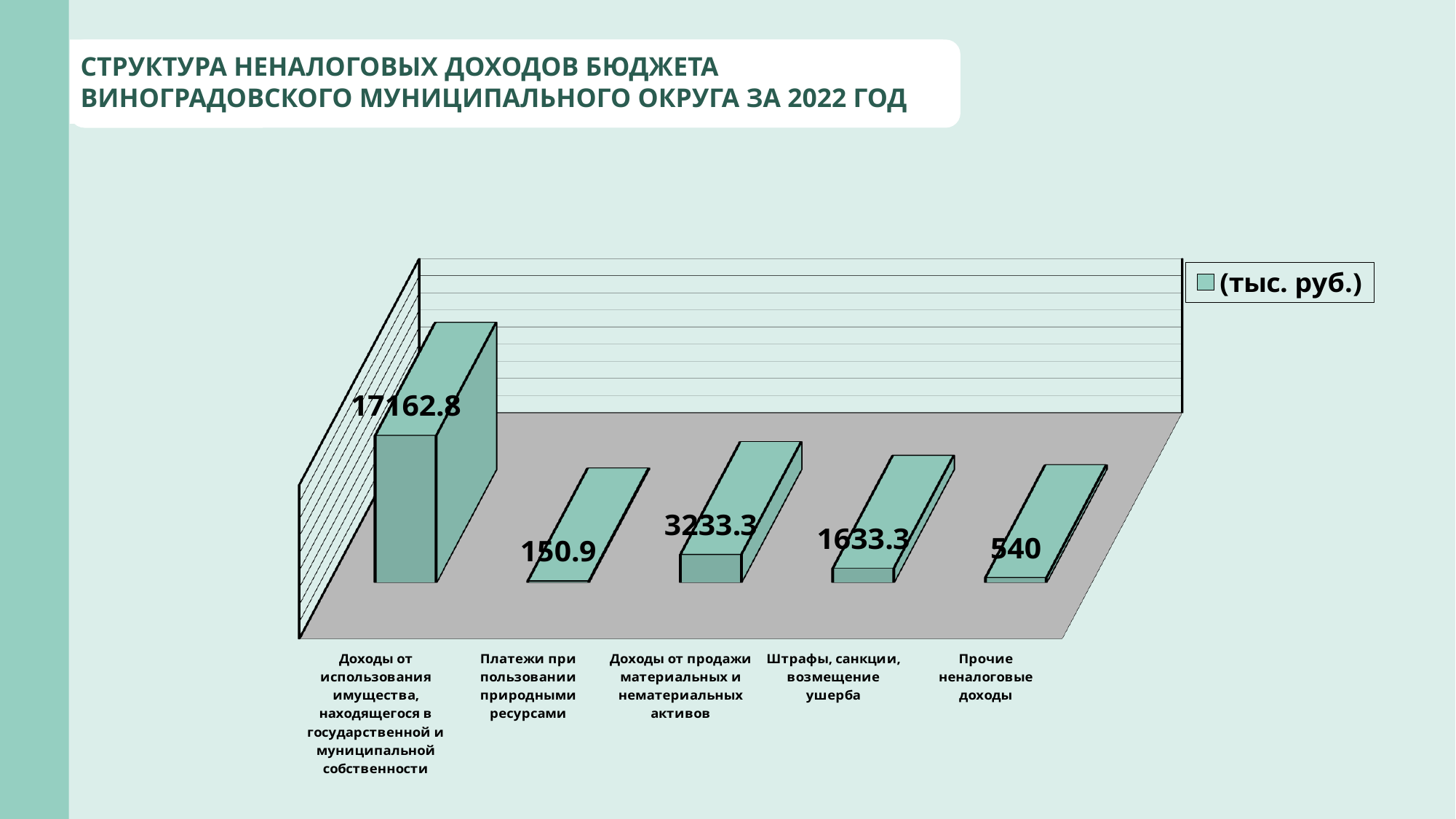
Which category has the lowest value? Платежи при пользовании природными ресурсами What kind of chart is shown on the slide? Bar chart How many series does the legend list? 1 What is the value for 'Платежи при пользовании природными ресурсами'? 150.9 What unit is given in the chart legend? (тыс. руб.) What is the value for 'Доходы от продажи материальных и нематериальных активов'? 3233.3 Which category has the highest value? Доходы от использования имущества, находящегося в государственной и муниципальной собственности What is the value for 'Штрафы, санкции, возмещение ущерба'? 1633.3 What is the value for 'Прочие неналоговые доходы'? 540 How many categories are shown in the chart? 5 What is the difference between the values for 'Доходы от продажи материальных и нематериальных активов' and 'Штрафы, санкции, возмещение ущерба'? 1600 Which is larger: the value for 'Прочие неналоговые доходы' or the value for 'Платежи при пользовании природными ресурсами'? Прочие неналоговые доходы